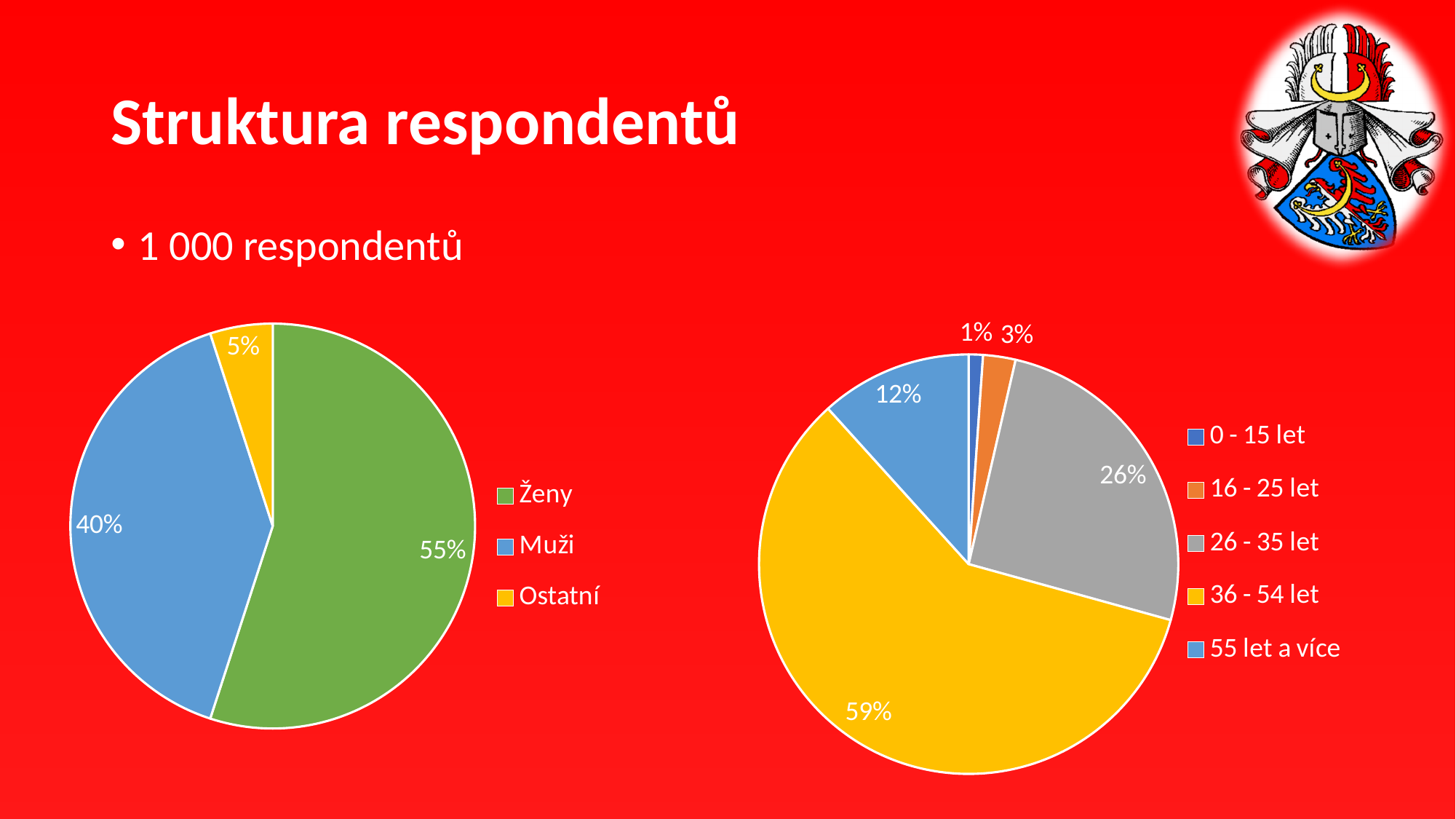
In the left pie chart, what share is labelled for Ženy? 55% How many categories does the legend of the right pie chart list? 5 What type of chart is shown on the right side of the slide? Pie chart In the left pie chart, what share is labelled for Muži? 40% In the right pie chart, which age group has the smallest slice? 0 - 15 let In the right pie chart, what share is labelled for 26 - 35 let? 26% In the right pie chart, what share is labelled for 55 let a více? 12% In the left pie chart, what is the difference in percentage points between Ženy and Muži? 15 In the right pie chart, which age group has the largest slice? 36 - 54 let In the right pie chart, what share is labelled for 36 - 54 let? 59% In the left pie chart, which category has the smallest slice? Ostatní How many categories does the legend of the left pie chart list? 3